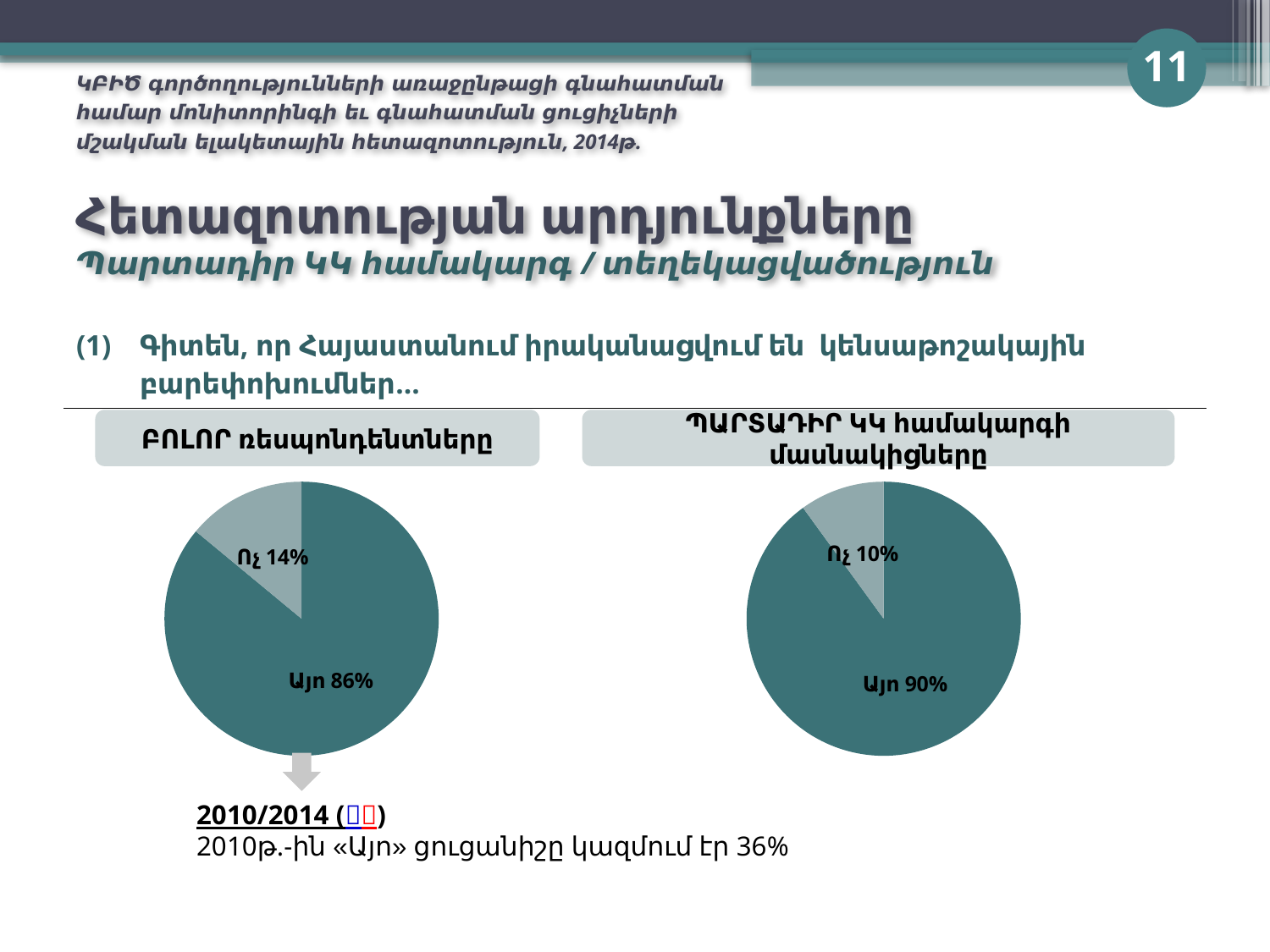
In the left pie chart (ԲՈԼՈՐ ռեսպոնդենտները), what share is labelled Այո? 86% How many slices does the right pie chart (ՊԱՐՏԱԴԻՐ ԿԿ համակարգի մասնակիցները) have? 2 How many pie charts are shown on the slide? 2 Which chart shows a larger Այո share, the left chart (ԲՈԼՈՐ ռեսպոնդենտները) or the right chart (ՊԱՐՏԱԴԻՐ ԿԿ համակարգի մասնակիցները)? The right chart (ՊԱՐՏԱԴԻՐ ԿԿ համակարգի մասնակիցները) In the left pie chart (ԲՈԼՈՐ ռեսպոնդենտները), which slice is the largest? Այո In the right pie chart (ՊԱՐՏԱԴԻՐ ԿԿ համակարգի մասնակիցները), what share is labelled Ոչ? 10% In the left pie chart (ԲՈԼՈՐ ռեսպոնդենտները), what share is labelled Ոչ? 14% What kind of chart is the left chart (ԲՈԼՈՐ ռեսպոնդենտները)? Pie chart In the right pie chart (ՊԱՐՏԱԴԻՐ ԿԿ համակարգի մասնակիցները), what share is labelled Այո? 90% In the left pie chart (ԲՈԼՈՐ ռեսպոնդենտները), what is the difference between the Այո and Ոչ shares? 72% What is the difference between the Ոչ share in the left pie chart and the Ոչ share in the right pie chart? 4% In the right pie chart (ՊԱՐՏԱԴԻՐ ԿԿ համակարգի մասնակիցները), which slice is the smallest? Ոչ